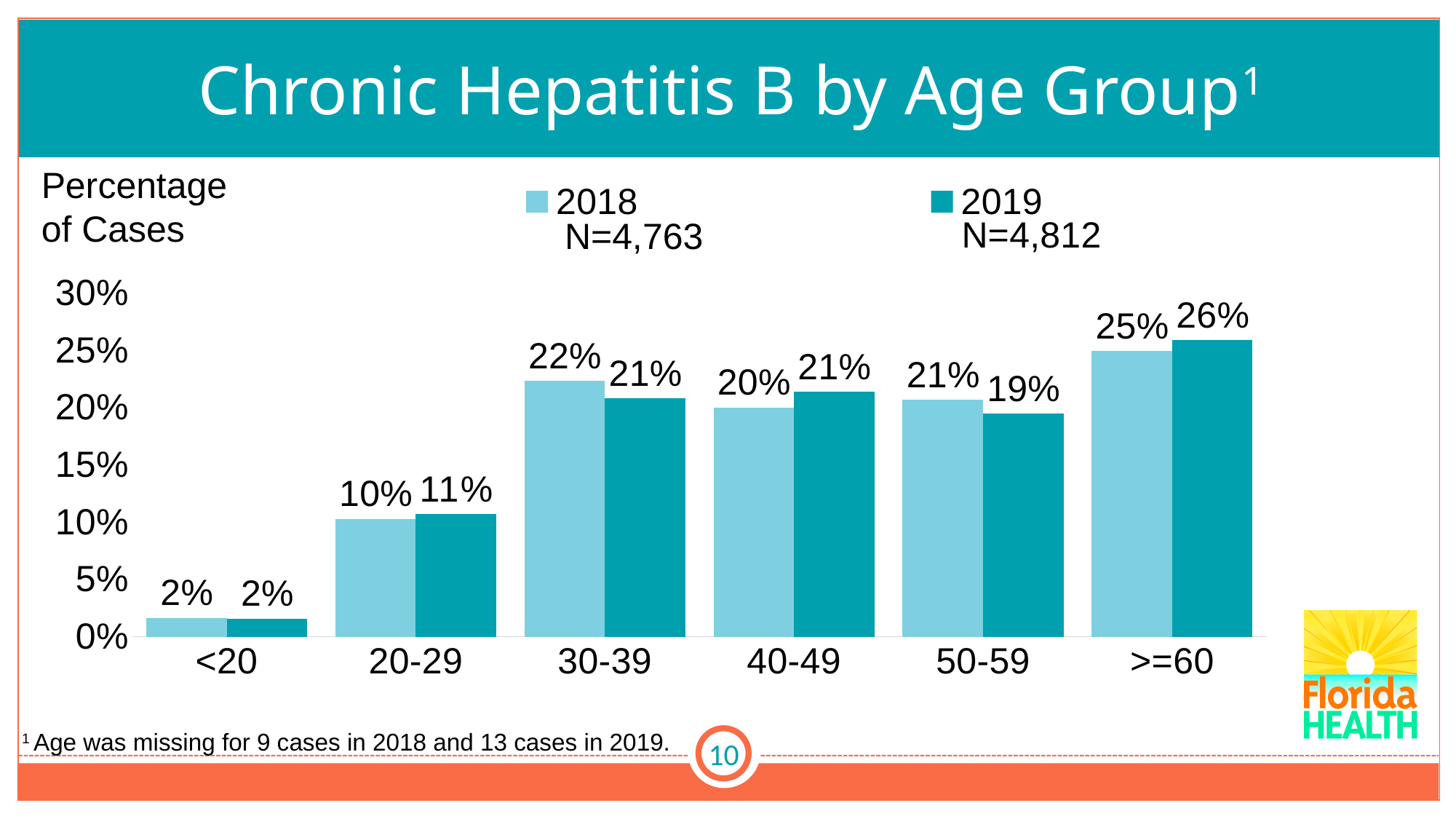
Which age group had the lowest percentage of cases in 2018? <20 How many series does the legend list? 2 What is the title of the chart? Chronic Hepatitis B by Age Group What kind of chart is shown on the slide? Bar chart Which age group had the highest percentage of cases in 2019? >=60 What is the N value shown in the legend for 2019? N=4,812 Which is larger for the 50-59 age group, the 2018 value or the 2019 value? 2018 What percentage of cases were in the 30-39 age group in 2018? 22% What percentage of cases were in the 50-59 age group in 2019? 19% How many age groups are shown on the x axis? 6 What is the difference between the 2019 and 2018 percentages for the 20-29 age group? 1% What percentage of cases were in the >=60 age group in 2019? 26%